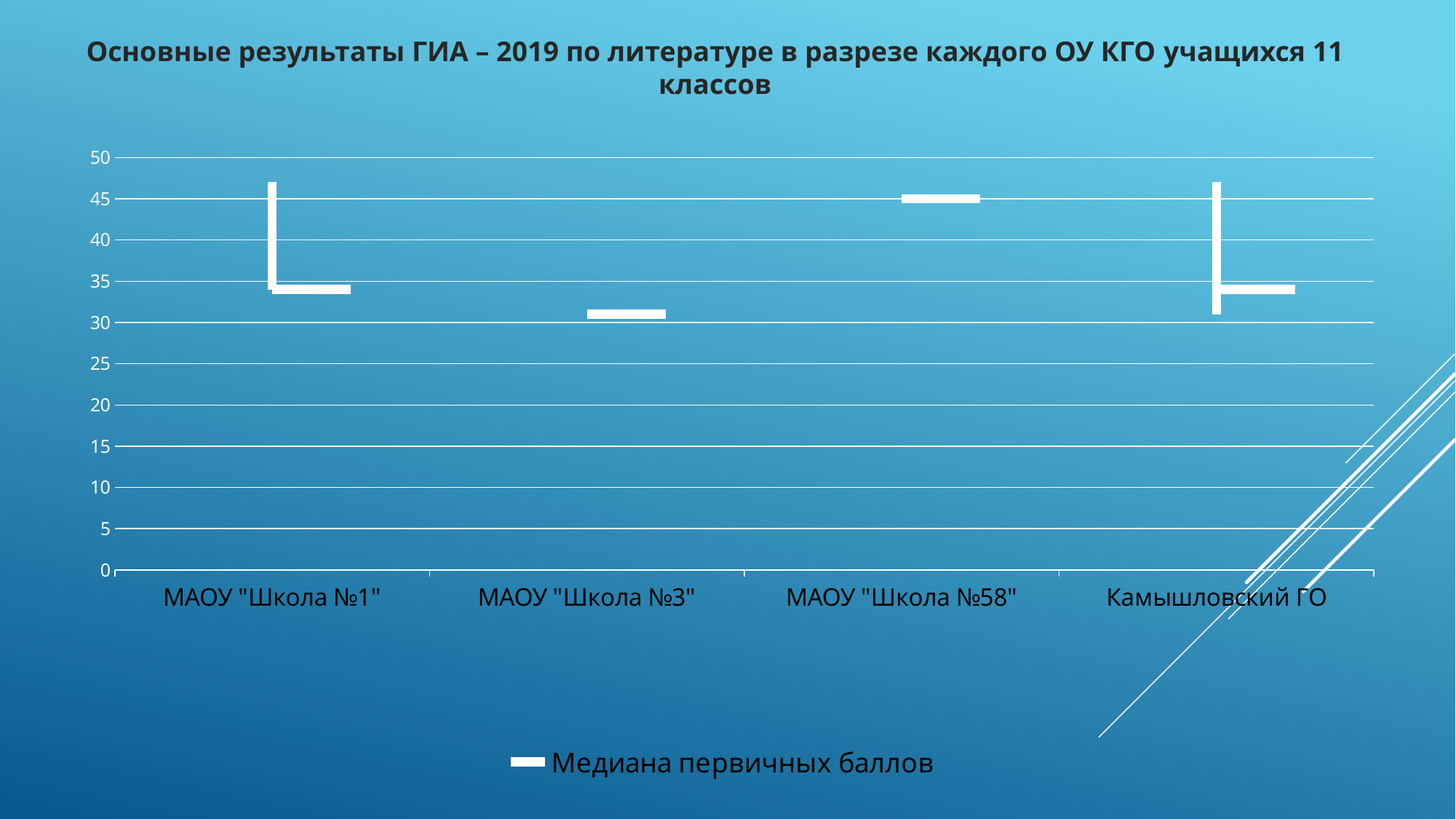
How many series does the chart legend list? 1 What is the maximum value shown on the vertical axis of the chart? 50 Which category has the lowest median marker in the chart? МАОУ "Школа №3" Is the median value for МАОУ "Школа №58" greater or less than 40? greater What is the name of the series shown in the chart legend? Медиана первичных баллов Which category has the highest median marker in the chart? МАОУ "Школа №58" How many categories are shown on the x axis of the chart? 4 Which has the larger median value: МАОУ "Школа №58" or МАОУ "Школа №3"? МАОУ "Школа №58" Is the median value for МАОУ "Школа №3" greater or less than 35? less Is the median value for МАОУ "Школа №1" greater or less than 40? less